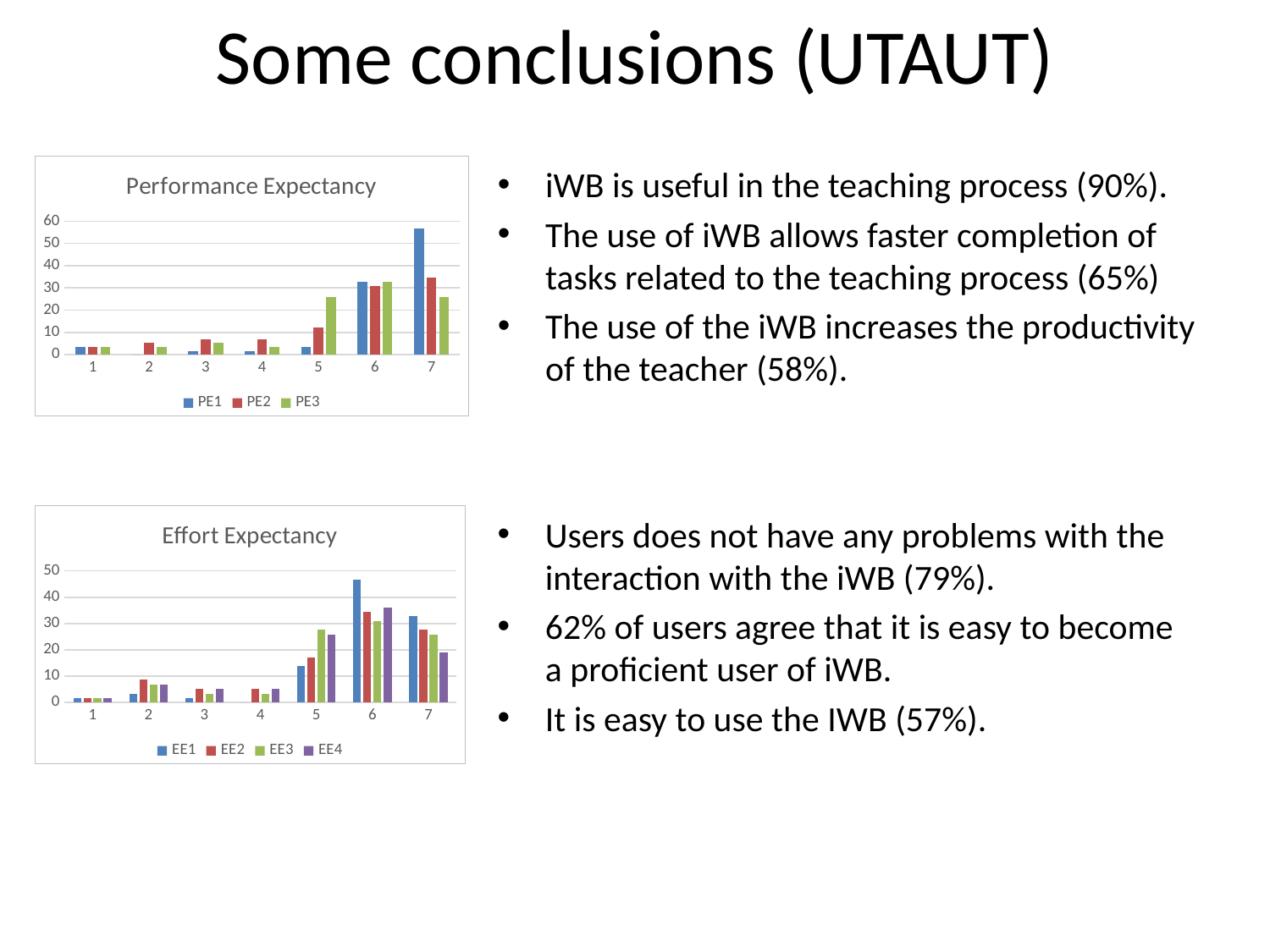
In the Performance Expectancy chart, is the value for PE1 at category 7 greater or less than 50? greater In the Performance Expectancy chart, which is larger at category 7: PE1 or PE2? PE1 How many categories are shown on the x axis of the Performance Expectancy chart? 7 In the Effort Expectancy chart, which series has the tallest bar at category 6? EE1 What is the title of the lower chart on the slide? Effort Expectancy In the Effort Expectancy chart, is the value for EE1 at category 6 greater or less than 40? greater In the Performance Expectancy chart, which category has the tallest bar? 7 How many series does the legend of the Performance Expectancy chart list? 3 How many series does the legend of the Effort Expectancy chart list? 4 In the Effort Expectancy chart, which is larger at category 7: EE1 or EE4? EE1 What type of chart is the Performance Expectancy chart? bar chart In the Performance Expectancy chart, is the value for PE3 at category 5 greater or less than 20? greater